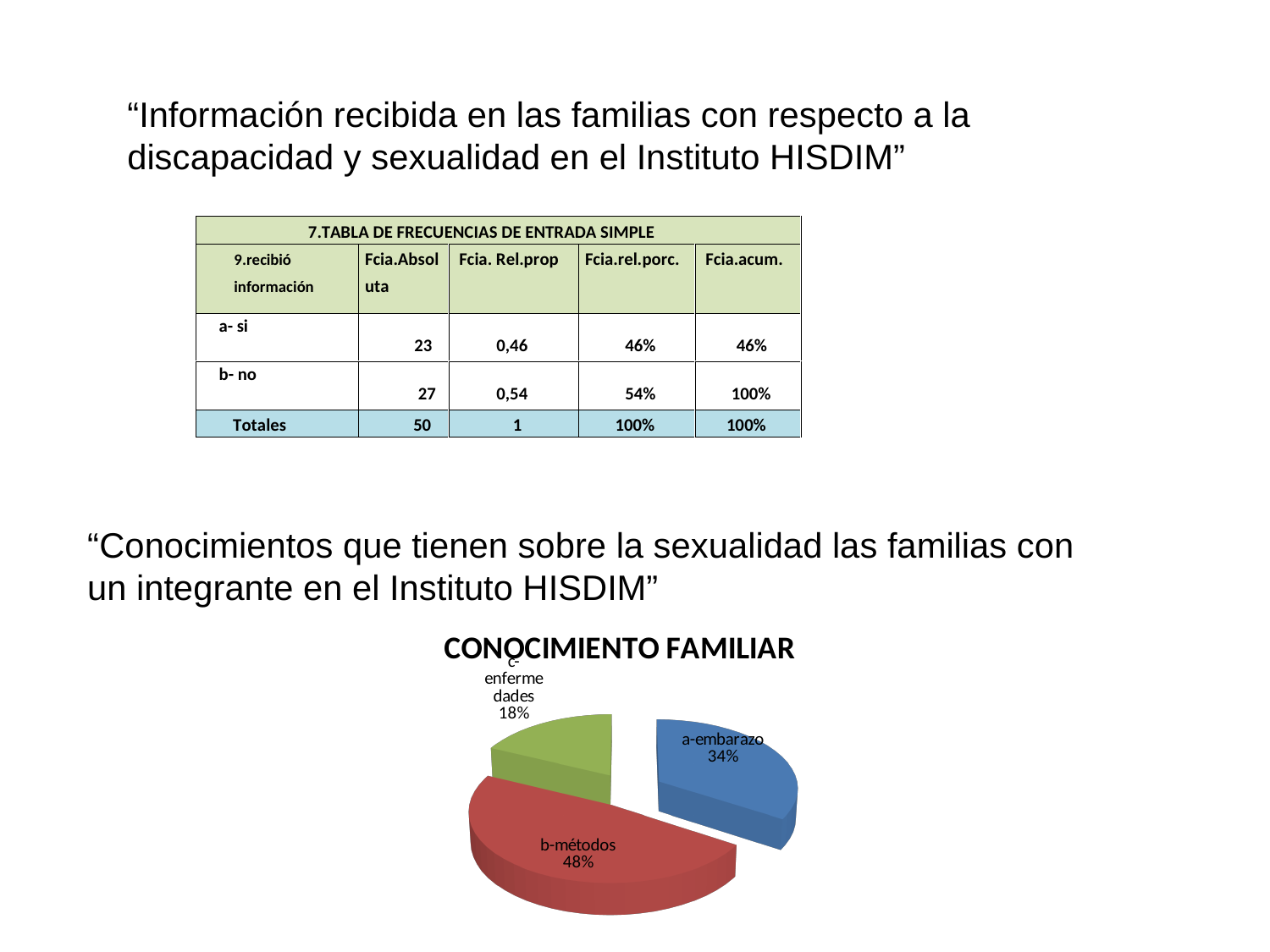
In the "CONOCIMIENTO FAMILIAR" pie chart, what percentage is shown for b-métodos? 48% In the "CONOCIMIENTO FAMILIAR" pie chart, what percentage is shown for c-enfermedades? 18% What kind of chart is the "CONOCIMIENTO FAMILIAR" chart? pie chart In the "CONOCIMIENTO FAMILIAR" pie chart, what colour is the b-métodos slice? red Which slice of the "CONOCIMIENTO FAMILIAR" pie chart is the largest? b-métodos In the "CONOCIMIENTO FAMILIAR" pie chart, what percentage is shown for a-embarazo? 34% In the "CONOCIMIENTO FAMILIAR" pie chart, what is the difference in percentage points between b-métodos and a-embarazo? 14 In the "CONOCIMIENTO FAMILIAR" pie chart, what is the difference in percentage points between a-embarazo and c-enfermedades? 16 Which slice of the "CONOCIMIENTO FAMILIAR" pie chart is the smallest? c-enfermedades How many slices does the "CONOCIMIENTO FAMILIAR" pie chart have? 3 What is the title of the pie chart on the slide? CONOCIMIENTO FAMILIAR In the "CONOCIMIENTO FAMILIAR" pie chart, which is larger: a-embarazo or c-enfermedades? a-embarazo